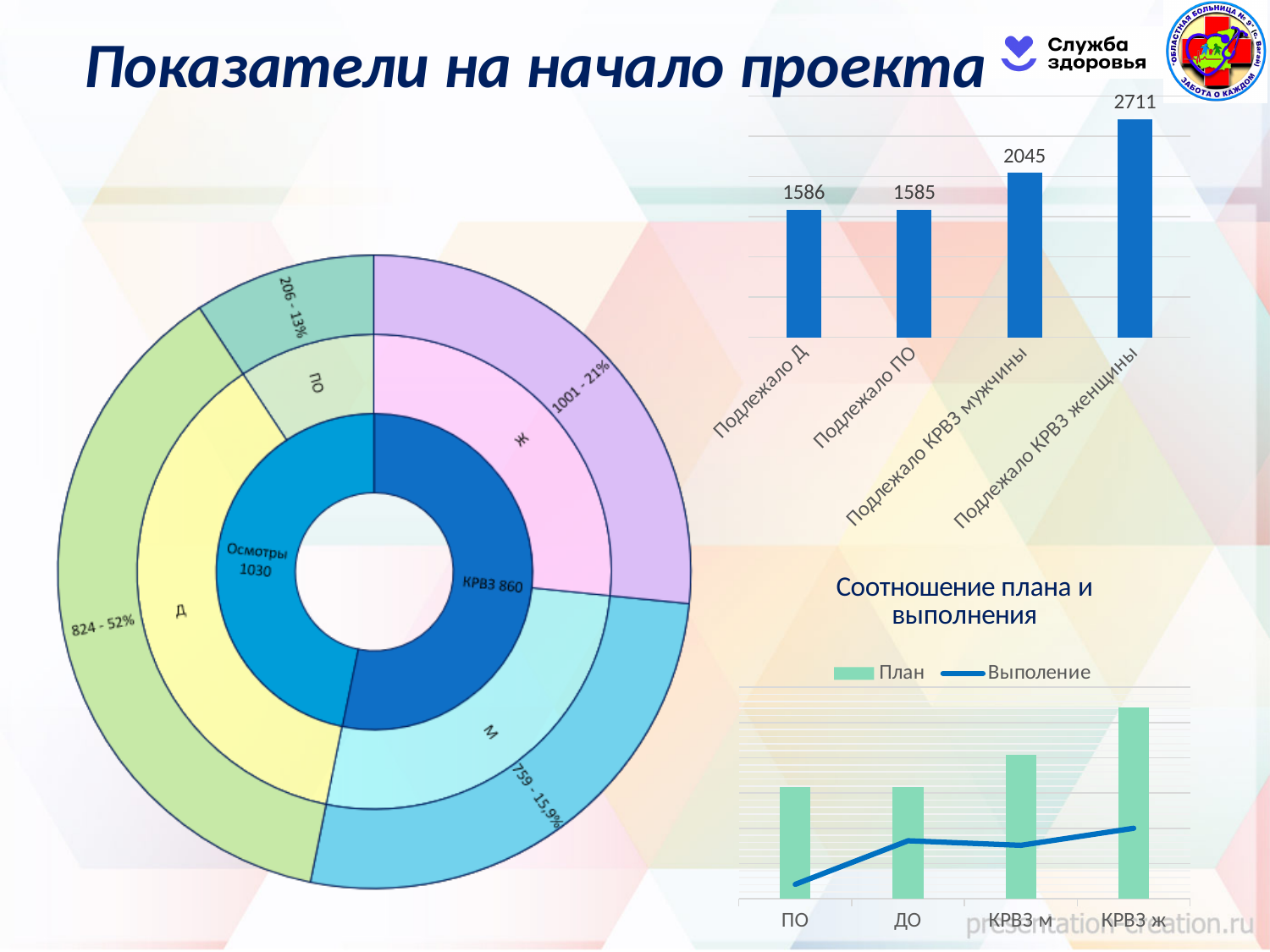
How many categories does the bar chart at the top right show? 4 In the bar chart at the top right, what is the difference between Подлежало КРВЗ женщины and Подлежало КРВЗ мужчины? 666 In the circular chart on the left, what value is shown for Осмотры in the inner ring? 1030 In the chart titled 'Соотношение плана и выполнения', does the Выполение line rise or fall from ПО to КРВЗ ж? rise In the bar chart at the top right, which is larger: Подлежало КРВЗ мужчины or Подлежало Д? Подлежало КРВЗ мужчины In the chart titled 'Соотношение плана и выполнения', which category has the highest План bar? КРВЗ ж In the bar chart at the top right, what is the value for Подлежало КРВЗ женщины? 2711 What kind of chart is the chart at the top right of the slide? bar chart In the bar chart at the top right, which category has the highest value? Подлежало КРВЗ женщины In the bar chart at the top right, which category has the lowest value? Подлежало ПО How many series does the legend of the chart titled 'Соотношение плана и выполнения' list? 2 In the bar chart at the top right, what is the value for Подлежало Д? 1586